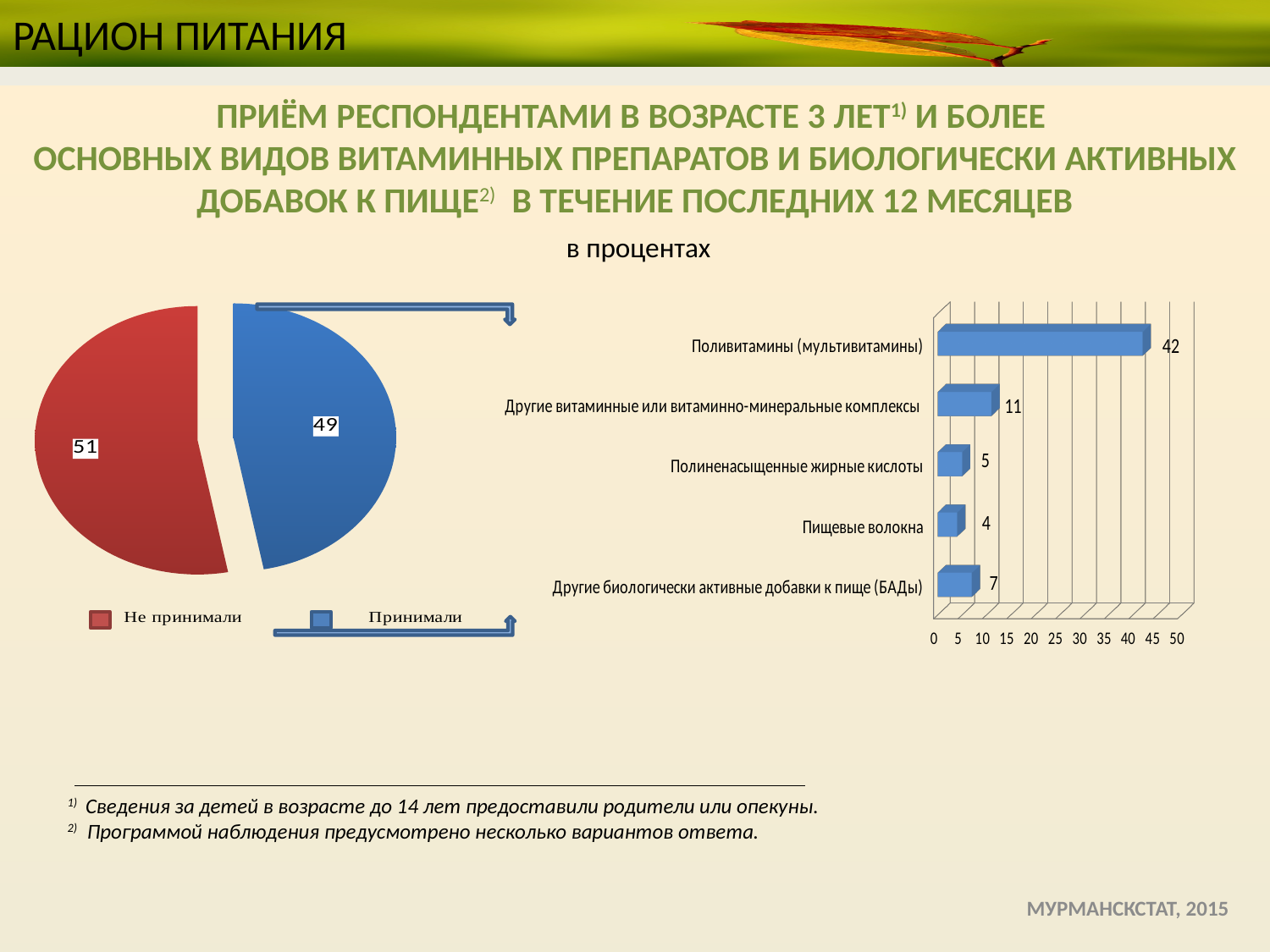
In the bar chart on the right, what is the difference between «Поливитамины (мультивитамины)» and «Другие витаминные или витаминно-минеральные комплексы»? 31 In the pie chart on the left, how many slices are there? 2 In the bar chart on the right, which category has the lowest value? Пищевые волокна In the pie chart on the left, what colour is the «Принимали» slice? Blue In the bar chart on the right, what is the value for «Пищевые волокна»? 4 In the pie chart on the left, what is the value for «Не принимали»? 51 In the bar chart on the right, which category has the highest value? Поливитамины (мультивитамины) In the pie chart on the left, which slice is larger: «Не принимали» or «Принимали»? Не принимали In the pie chart on the left, what is the value for «Принимали»? 49 What type of chart is shown on the right side of the slide? Bar chart In the bar chart on the right, what is the value for «Поливитамины (мультивитамины)»? 42 In the bar chart on the right, how many categories are shown? 5